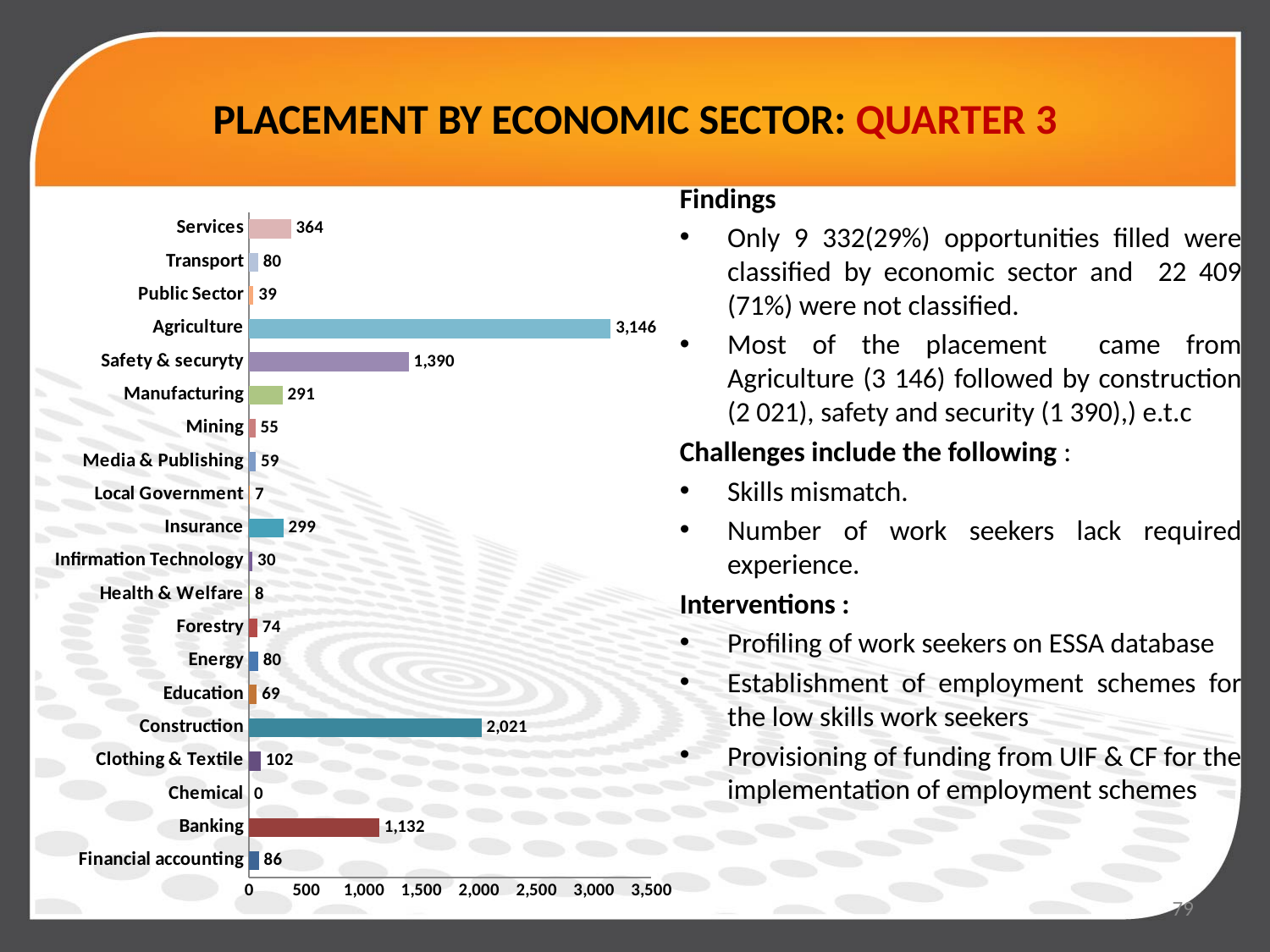
What is the value for Banking? 1,132 What is the value for Agriculture? 3,146 Which sector has the lowest value? Chemical Which is larger, the value for Services or the value for Manufacturing? Services What is the value for Insurance? 299 What is the maximum value shown on the horizontal axis? 3,500 What is the difference between the values for Agriculture and Construction? 1,125 What is the difference between the values for Safety & securyty and Banking? 258 How many sectors are shown in the chart? 20 What is the value for Construction? 2,021 What kind of chart is shown on the slide? Bar chart Which sector has the highest value? Agriculture